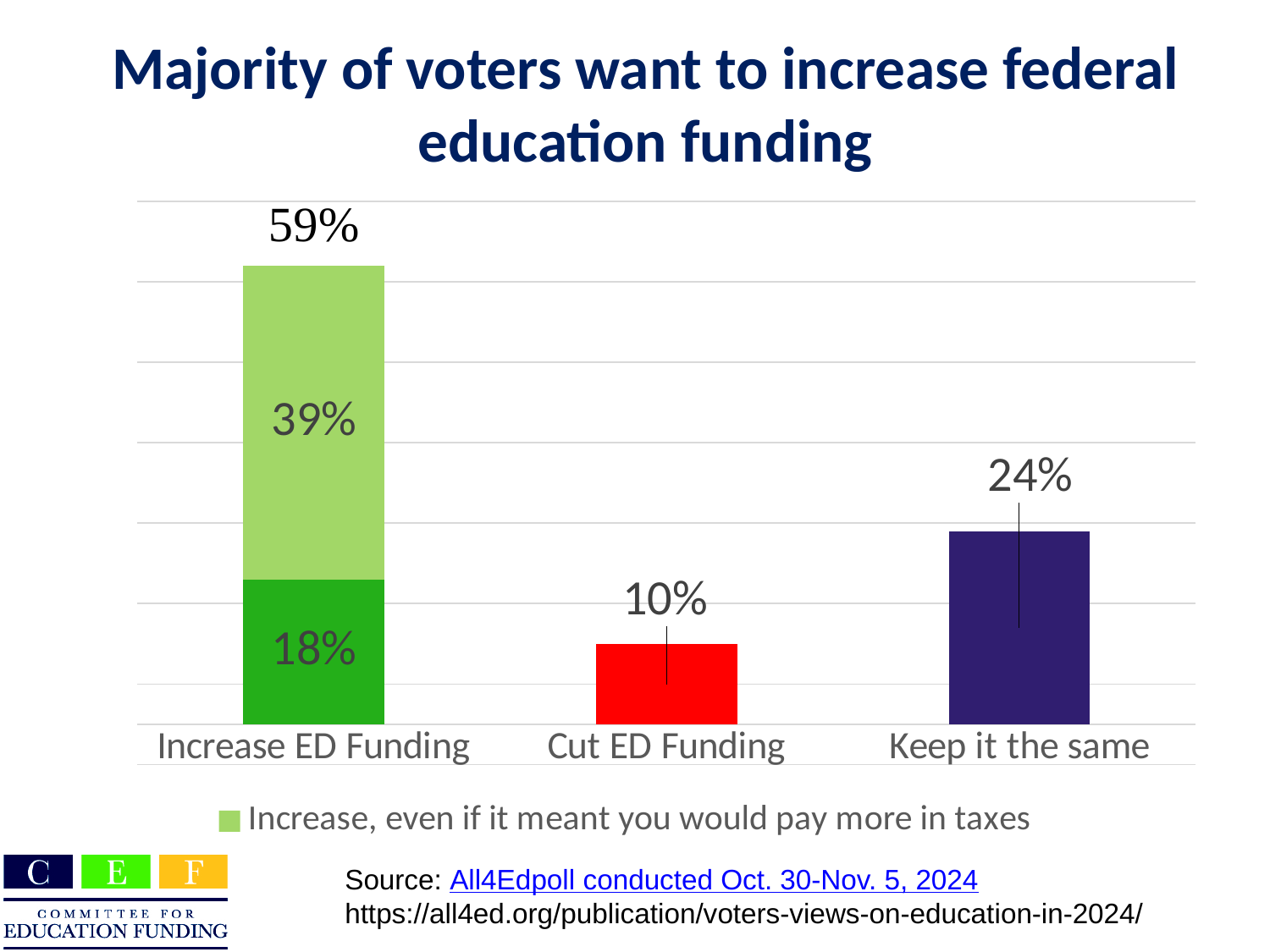
What is the difference between the value for Keep it the same and the value for Cut ED Funding? 14% What is the value for Cut ED Funding? 10% Which is larger, the value for Keep it the same or the value for Cut ED Funding? Keep it the same What is the total value shown above the Increase ED Funding bar? 59% What is the value of the dark green bottom segment of the Increase ED Funding bar? 18% What is the title of the chart on the slide? Majority of voters want to increase federal education funding Which category has the highest total value? Increase ED Funding What kind of chart is shown on the slide? Bar chart What is the value of the light green segment (Increase, even if it meant you would pay more in taxes) in the Increase ED Funding bar? 39% What is the value for Keep it the same? 24% Which category has the lowest value? Cut ED Funding How many categories are shown on the x axis? 3